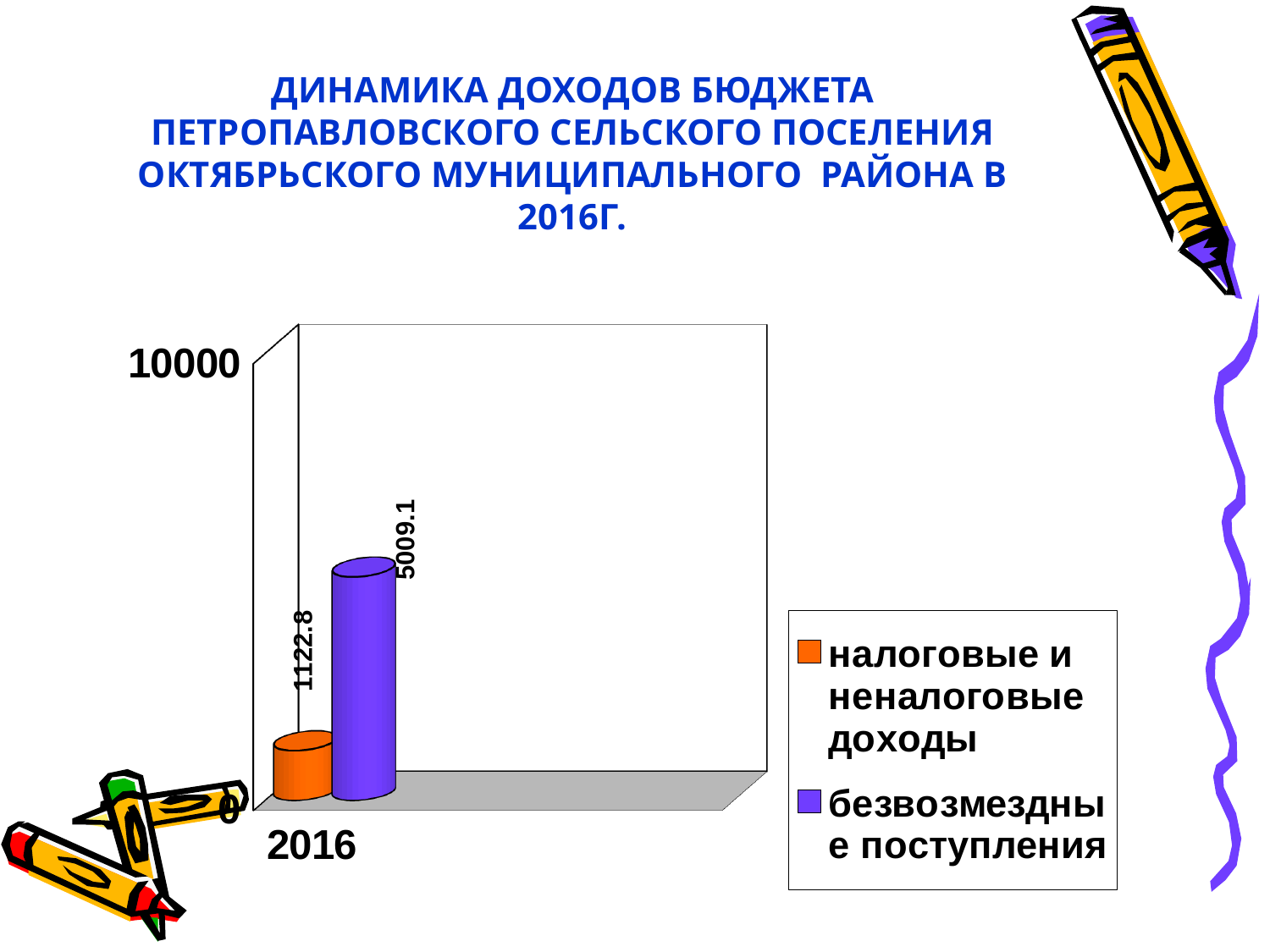
How many categories are shown on the x axis? 1 What kind of chart is shown on the slide? bar chart What is the total of налоговые и неналоговые доходы and безвозмездные поступления in 2016? 6131.9 What is the value for налоговые и неналоговые доходы in 2016? 1122.8 Which year is shown on the x axis of the chart? 2016 What is the value for безвозмездные поступления in 2016? 5009.1 How many series does the legend list? 2 Which series has the higher value in 2016, налоговые и неналоговые доходы or безвозмездные поступления? безвозмездные поступления Is the value for безвозмездные поступления greater or less than 10000? less What colour represents безвозмездные поступления in the legend? purple What is the difference between безвозмездные поступления and налоговые и неналоговые доходы in 2016? 3886.3 Which series has the lowest value on the chart? налоговые и неналоговые доходы